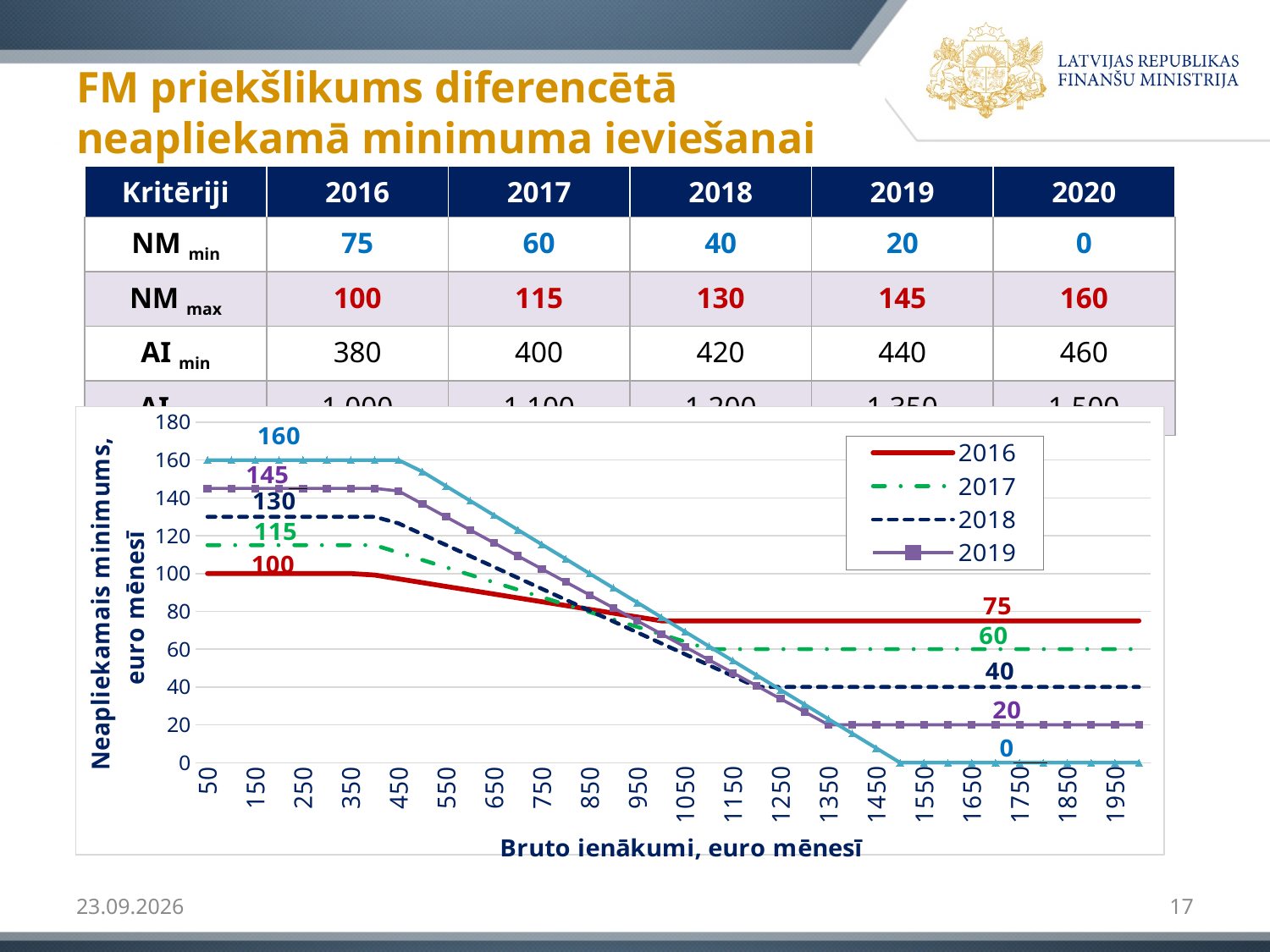
What type of chart is shown on the slide? line chart What is the data label at the left (low-income) end of the 2016 line? 100 What is the title of the x axis of the chart? Bruto ienākumi, euro mēnesī What is the data label at the left end of the 2019 line? 145 What is the data label at the right (high-income) end of the 2016 line? 75 At 1950 on the x axis, which is larger: the 2017 line or the 2018 line? 2017 How many series does the chart legend list? 4 Which series has the highest value at the right end of the chart (at 1950)? 2016 What is the data label at the right end of the 2018 line? 40 Is the value of the 2016 line at 550 on the x axis greater or less than 80? greater Do the values of the 2016 line rise or fall as gross income increases along the x axis? fall What is the difference between the left-end label (145) and the right-end label (20) of the 2019 line? 125